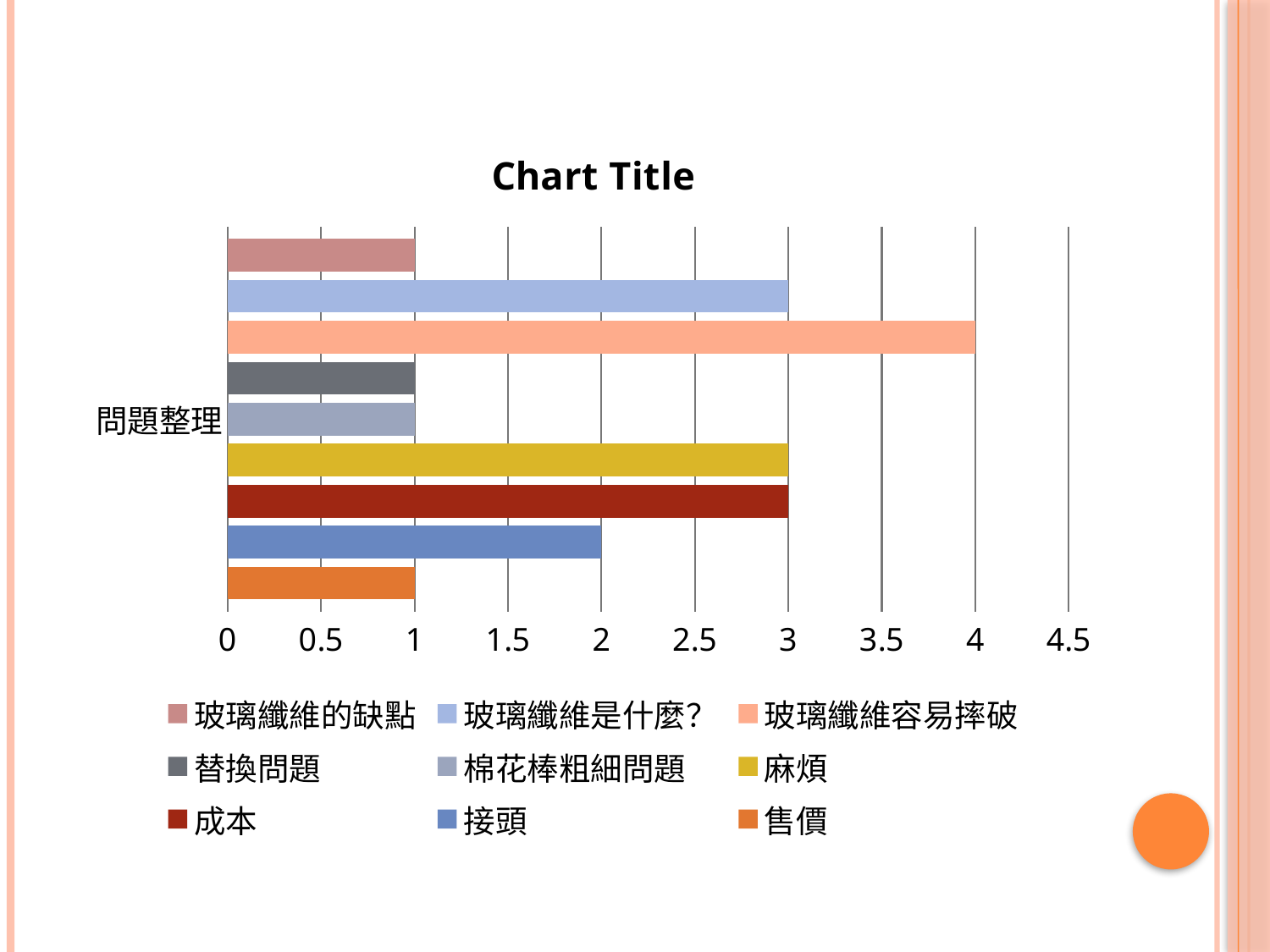
What is the value for 玻璃纖維容易摔破? 4 What is the title of the chart? Chart Title Is the value for 成本 greater or less than 2? greater What type of chart is shown on the slide? bar chart What is the value for 售價? 1 What is the category label shown on the vertical axis? 問題整理 What is the value for 接頭? 2 Which series has the highest value? 玻璃纖維容易摔破 What is the value for 玻璃纖維是什麼? 3 Which is larger, the value for 麻煩 or the value for 替換問題? 麻煩 What is the difference between the values for 玻璃纖維容易摔破 and 接頭? 2 How many series does the legend list? 9